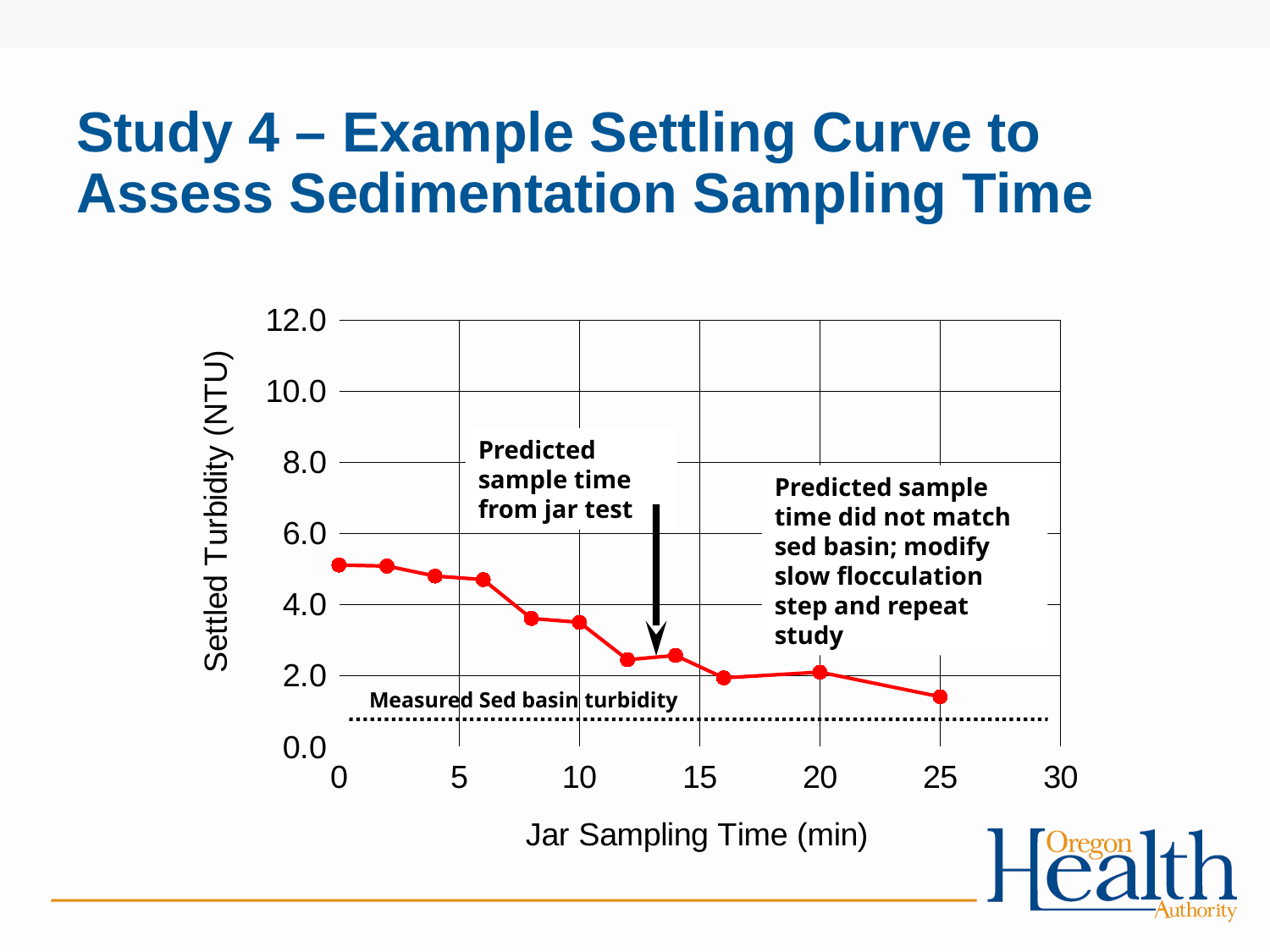
What is the label of the y axis? Settled Turbidity (NTU) How many data points are plotted on the settling curve? 11 Which has the higher settled turbidity, the point at 0 min or the point at 25 min? 0 min At which jar sampling time is the settled turbidity lowest? 25 Is the settled turbidity at 0 min greater or less than 4.0? greater What kind of chart is shown on the slide? line chart Is the settled turbidity at 25 min greater or less than 2.0? less Is the settled turbidity at 0 min greater or less than 6.0? less Which has the higher settled turbidity, the point at 6 min or the point at 8 min? 6 min Do the settled turbidity values rise or fall as jar sampling time increases? fall What is the label of the x axis? Jar Sampling Time (min)